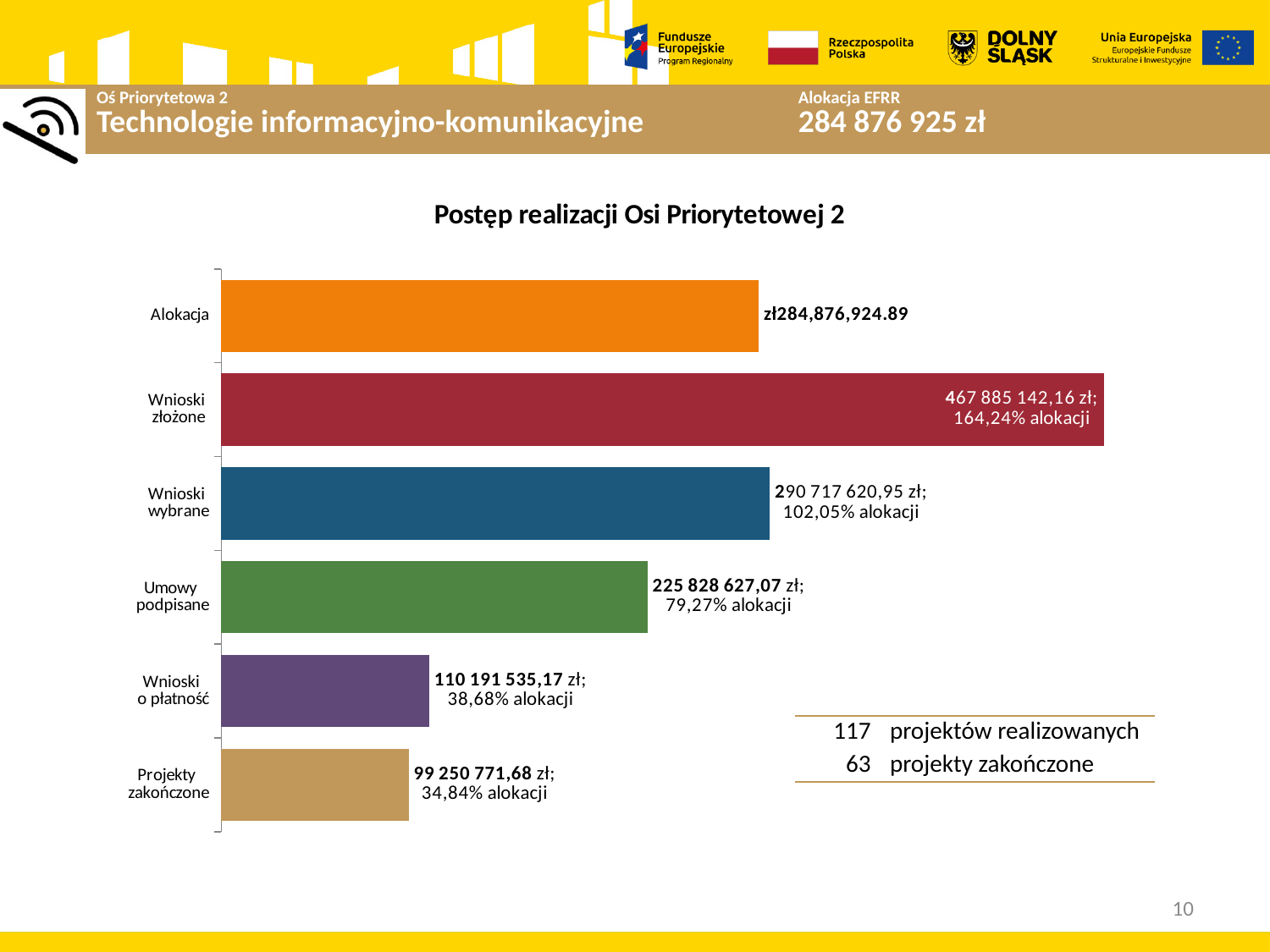
How many categories does the chart show? 6 What kind of chart is shown on the slide? bar chart What percentage of the allocation do Wnioski wybrane represent? 102,05% What percentage of the allocation do Umowy podpisane represent? 79,27% Which category has the lowest value? Projekty zakończone What value is shown for Alokacja? zł284,876,924.89 Which category has the highest value? Wnioski złożone What is the difference between Wnioski o płatność and Projekty zakończone? 10 940 763,49 zł What amount is shown for Wnioski złożone? 467 885 142,16 zł What is the title of the chart? Postęp realizacji Osi Priorytetowej 2 What amount is shown for Projekty zakończone? 99 250 771,68 zł Which is larger, Wnioski wybrane or Umowy podpisane? Wnioski wybrane